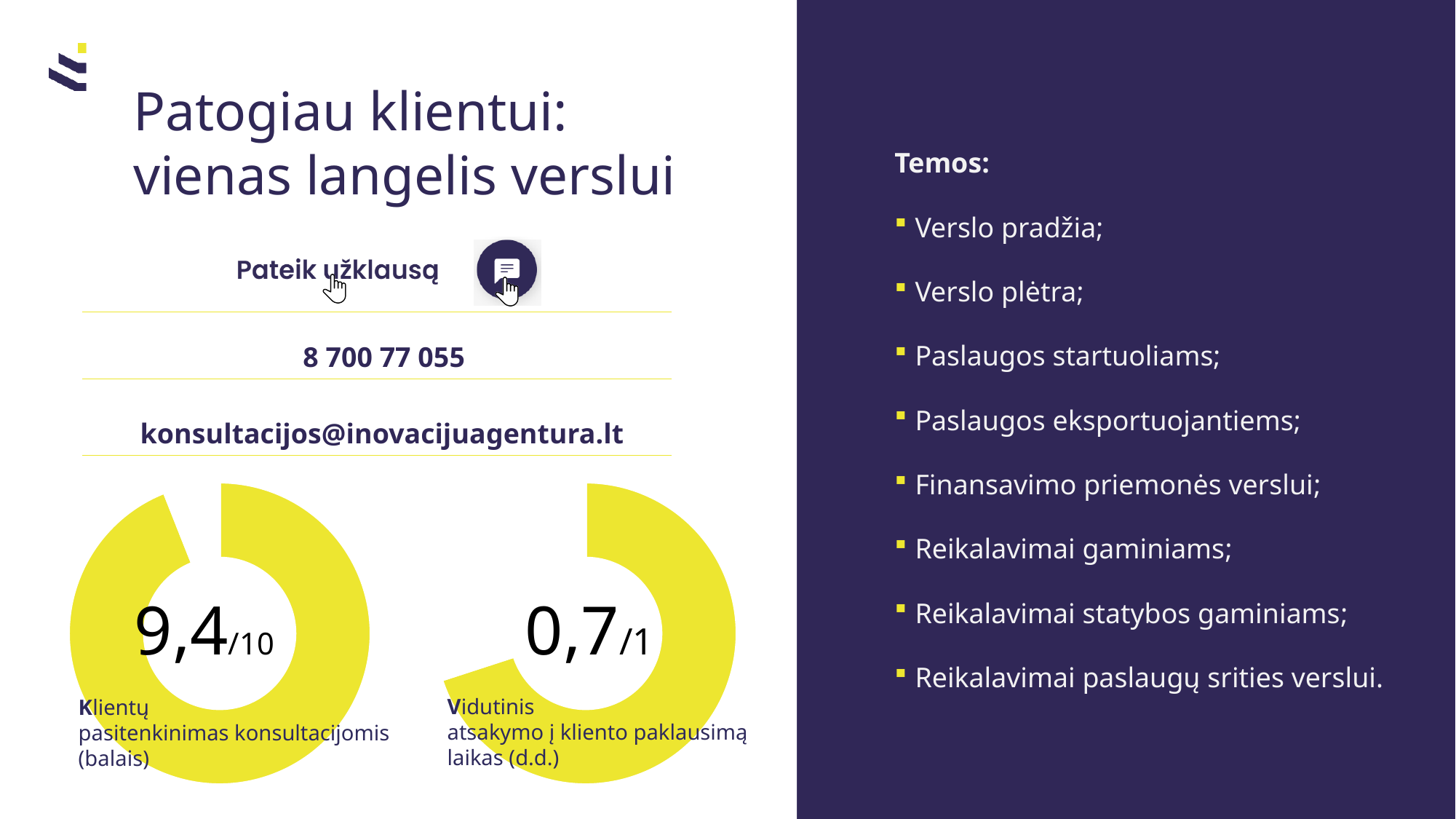
What kind of chart is used to display the 9,4/10 customer satisfaction score? Doughnut (pie) chart How many doughnut charts are shown on the slide? 2 What is the maximum scale value for the right doughnut chart (Vidutinis atsakymo į kliento paklausimą laikas)? 1 What is the average response time to a client enquiry (Vidutinis atsakymo į kliento paklausimą laikas) shown on the slide, in d.d.? 0,7 What value is shown in the centre of the right doughnut chart (Vidutinis atsakymo į kliento paklausimą laikas)? 0,7/1 What is the customer satisfaction score with consultations (Klientų pasitenkinimas konsultacijomis) shown on the slide? 9,4 What unit is given for the left doughnut chart's customer satisfaction value? balais What is the maximum scale value for the left doughnut chart (Klientų pasitenkinimas konsultacijomis)? 10 What value is shown in the centre of the left doughnut chart (Klientų pasitenkinimas konsultacijomis)? 9,4/10 What colour is the filled ring of the doughnut charts on the slide? Yellow